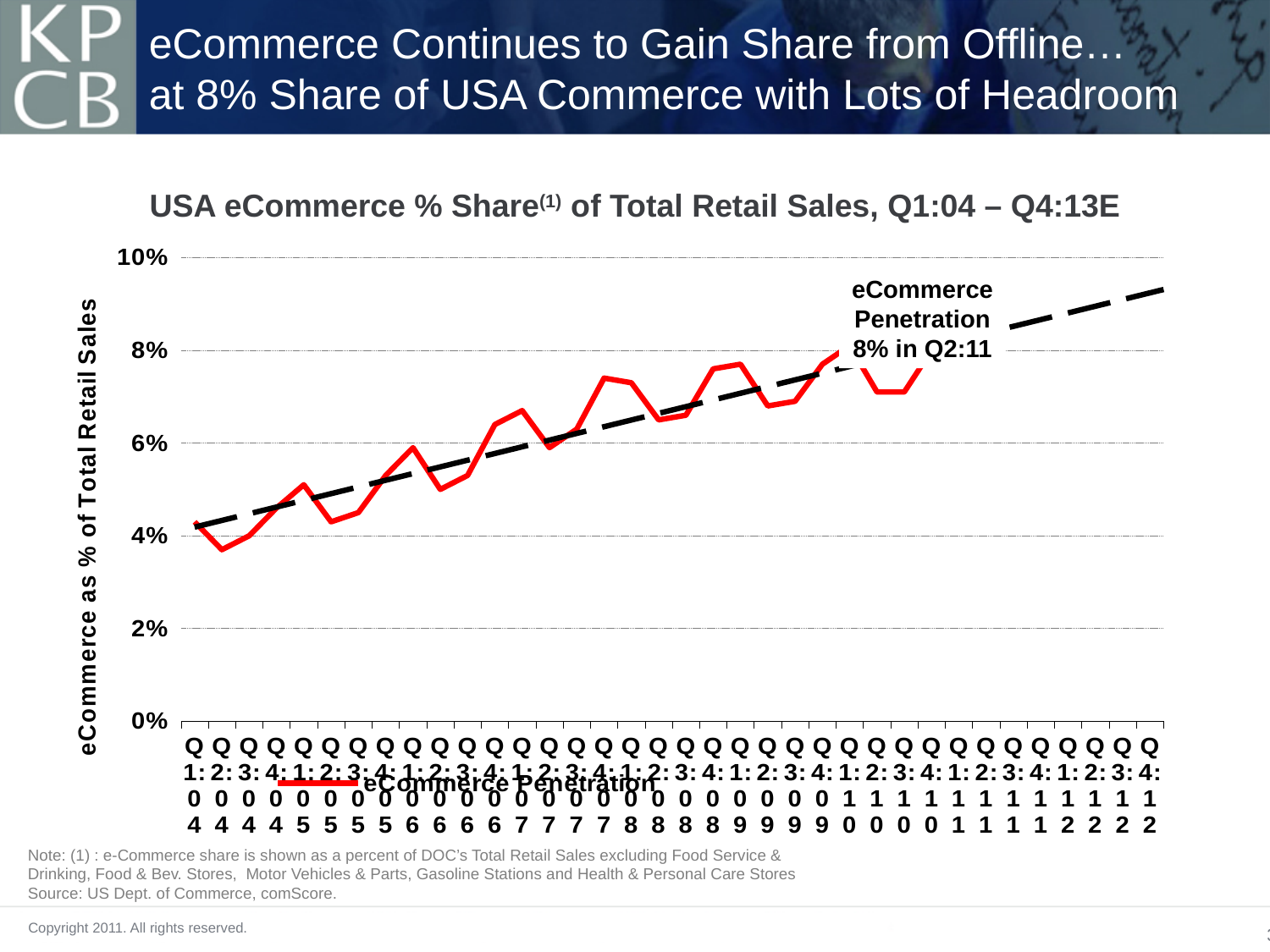
Is the eCommerce penetration value for Q2:11 greater or less than 6%? greater What is the title of the chart? USA eCommerce % Share(1) of Total Retail Sales, Q1:04 – Q4:13E How many series does the chart legend list? 1 What is the label on the vertical axis of the chart? eCommerce as % of Total Retail Sales What kind of chart is shown on the slide? line chart Which is larger, the eCommerce penetration in Q1:04 or in Q2:11? Q2:11 What is the eCommerce penetration value in Q2:11 according to the annotation on the chart? 8% Is the eCommerce penetration value for Q1:04 greater or less than 6%? less Does eCommerce penetration generally rise or fall from Q1:04 to Q2:11? rise